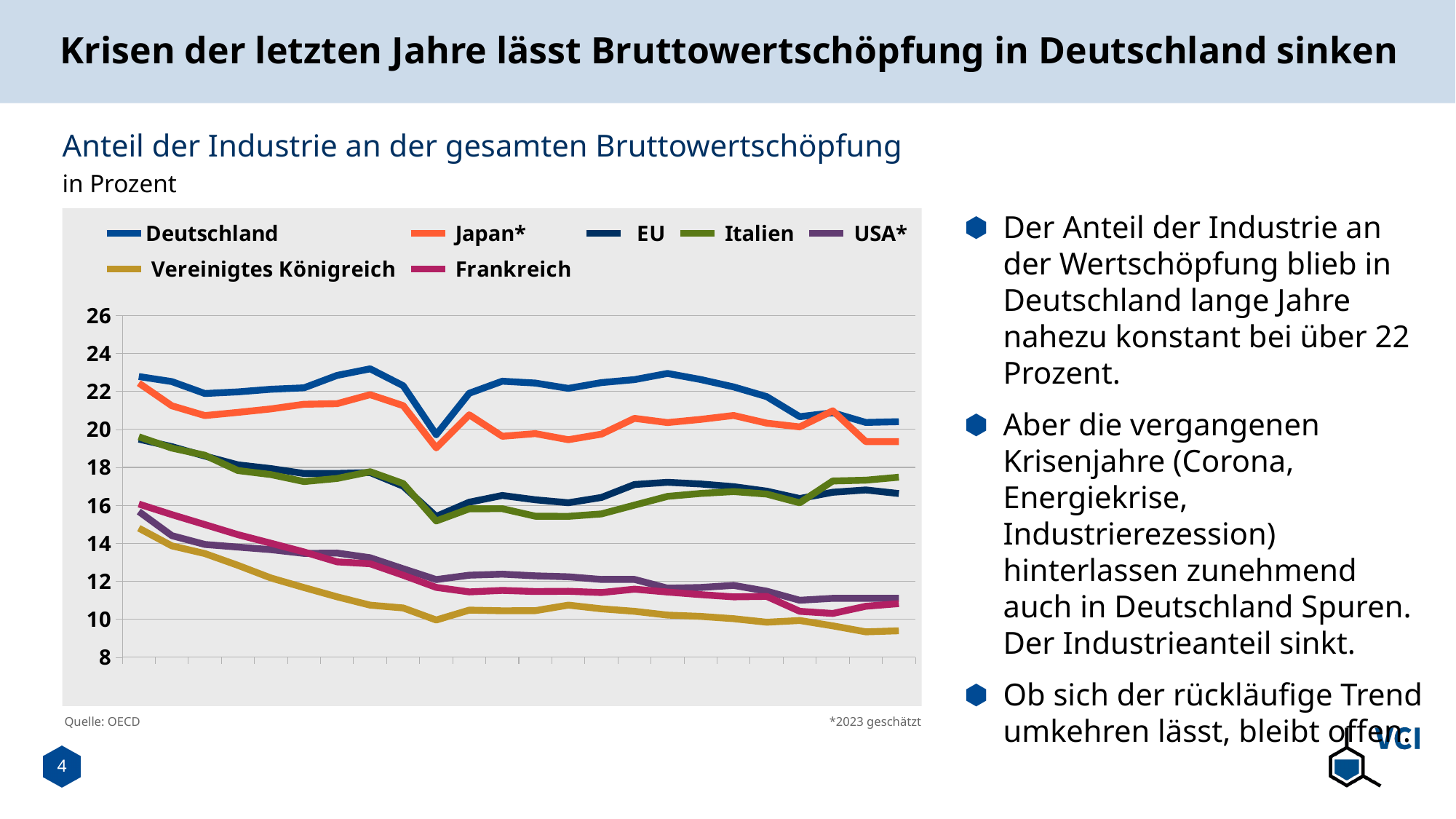
What kind of chart is shown on the slide? line chart Which series has the lowest values across the whole chart? Vereinigtes Königreich Does the Vereinigtes Königreich line rise or fall from the left end of the chart to the right end? fall How many series does the chart legend list? 7 Is the value for Deutschland at the left end of the chart greater or less than 22? greater Does the Deutschland line rise or fall from the left end of the chart to the right end? fall Is the value for Vereinigtes Königreich at the right end of the chart greater or less than 10? less What source is given for the chart? OECD At the right end of the chart, which is higher: Deutschland or Japan*? Deutschland Is the value for Japan* at the right end of the chart greater or less than 20? less Which series has the highest values across the whole chart? Deutschland What is the title of the chart? Anteil der Industrie an der gesamten Bruttowertschöpfung